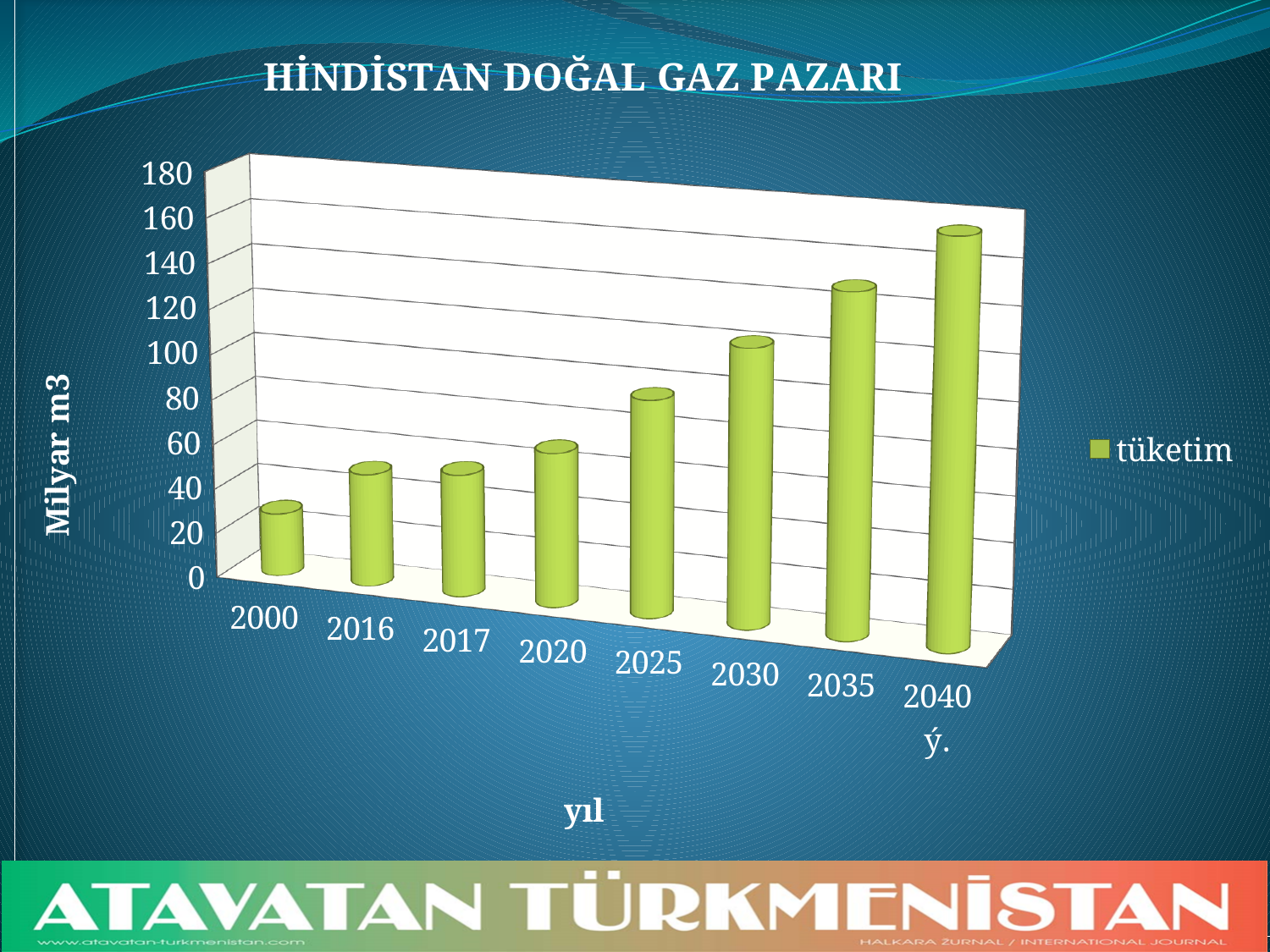
What is the title of the chart? HİNDİSTAN DOĞAL GAZ PAZARI What kind of chart is shown on the slide? bar chart What is the label of the vertical axis? Milyar m3 Is the value for 2000 greater or less than 60? less Is the value for 2040 greater or less than 100? greater Which year has the highest consumption (tüketim) value? 2040 Which is larger, the value for 2030 or the value for 2020? 2030 Which year has the lowest consumption (tüketim) value? 2000 How many years (categories) are shown on the x axis? 8 How many series does the legend list? 1 Is the value for 2035 greater or less than 100? greater Do the values generally rise or fall from 2000 to 2040? rise